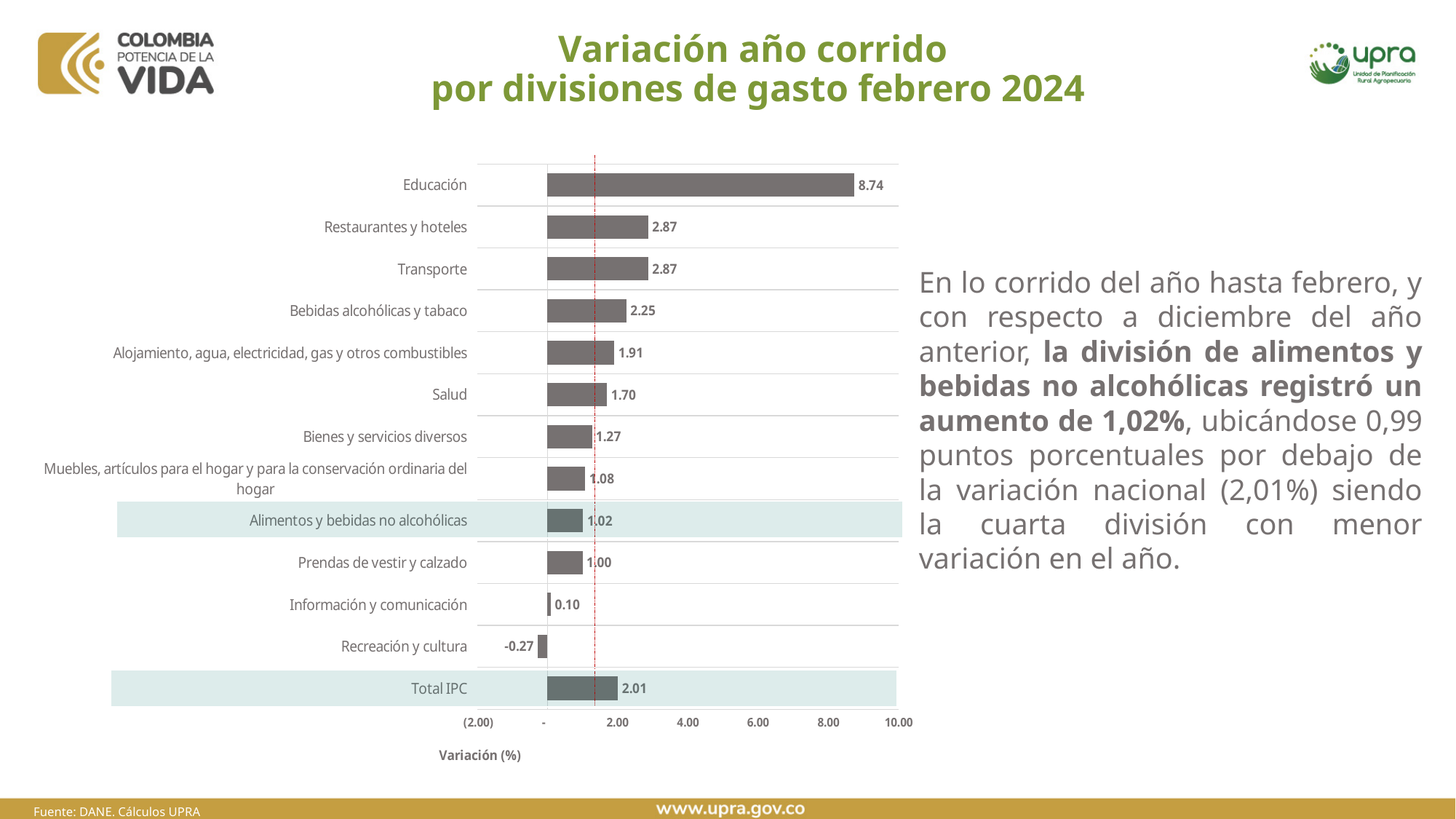
What is the value for Educación? 8.74 Which category has the highest value? Educación What is the value for Alimentos y bebidas no alcohólicas? 1.02 What is the value for Recreación y cultura? -0.27 What is the difference between the value for Total IPC and the value for Alimentos y bebidas no alcohólicas? 0.99 What is the label of the horizontal axis? Variación (%) What is the value for Total IPC? 2.01 How many categories are shown in the chart? 13 Is the value for Bebidas alcohólicas y tabaco greater or less than 2.00? greater Which category has the lowest value? Recreación y cultura What kind of chart is shown on the slide? Bar chart Which is larger, the value for Salud or the value for Bienes y servicios diversos? Salud